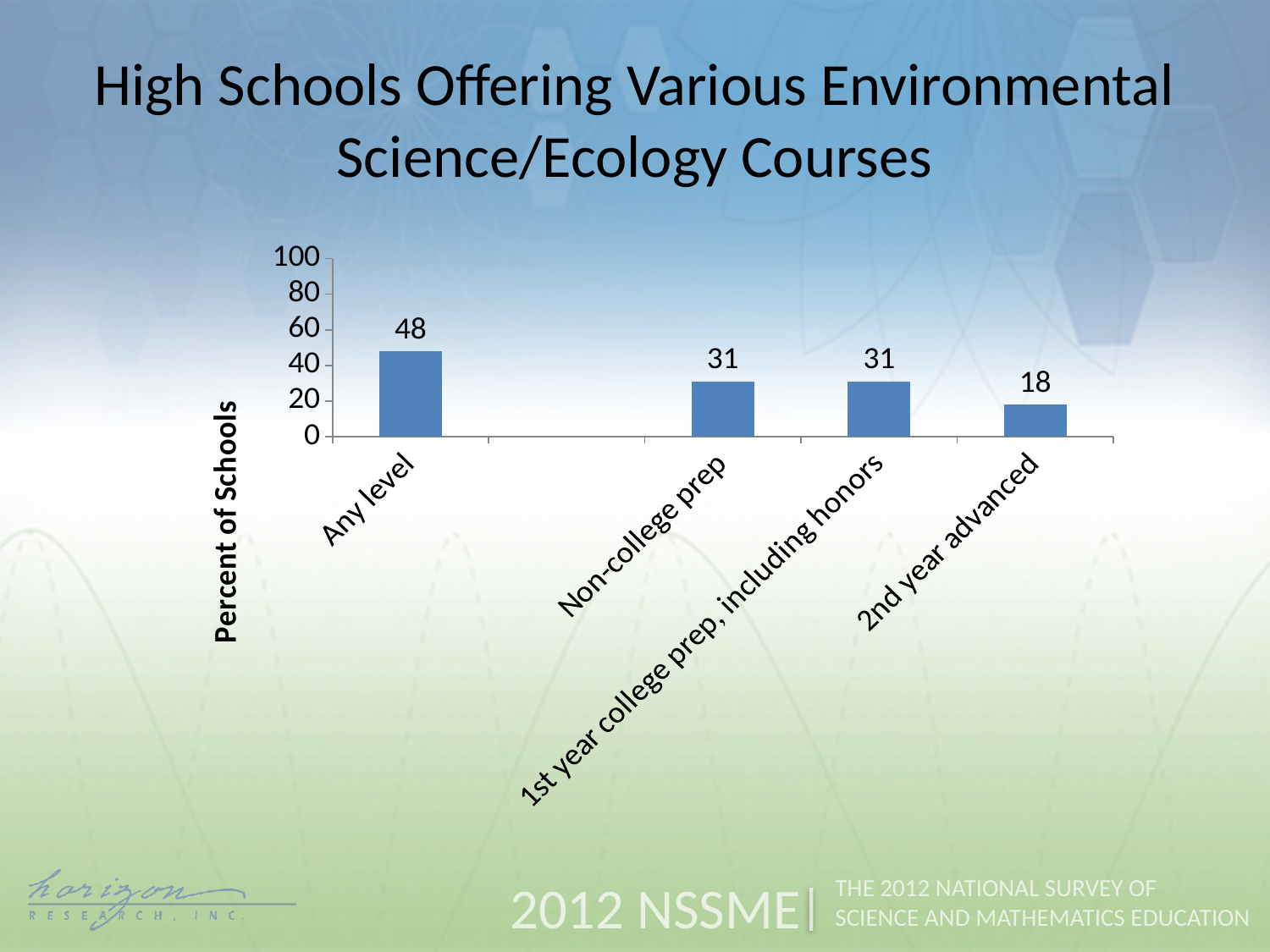
How many categories are shown on the chart? 4 Which category has the lowest value? 2nd year advanced Which category has the highest value? Any level Which is larger, the value for Non-college prep or the value for 2nd year advanced? Non-college prep What is the difference between the values for Any level and Non-college prep? 17 What percent of high schools offer environmental science/ecology at any level? 48 What kind of chart is shown on the slide? Bar chart What is the value for 2nd year advanced? 18 What is the difference between the values for Any level and 2nd year advanced? 30 What is the label of the vertical axis? Percent of Schools What is the value for 1st year college prep, including honors? 31 What is the value for Non-college prep? 31